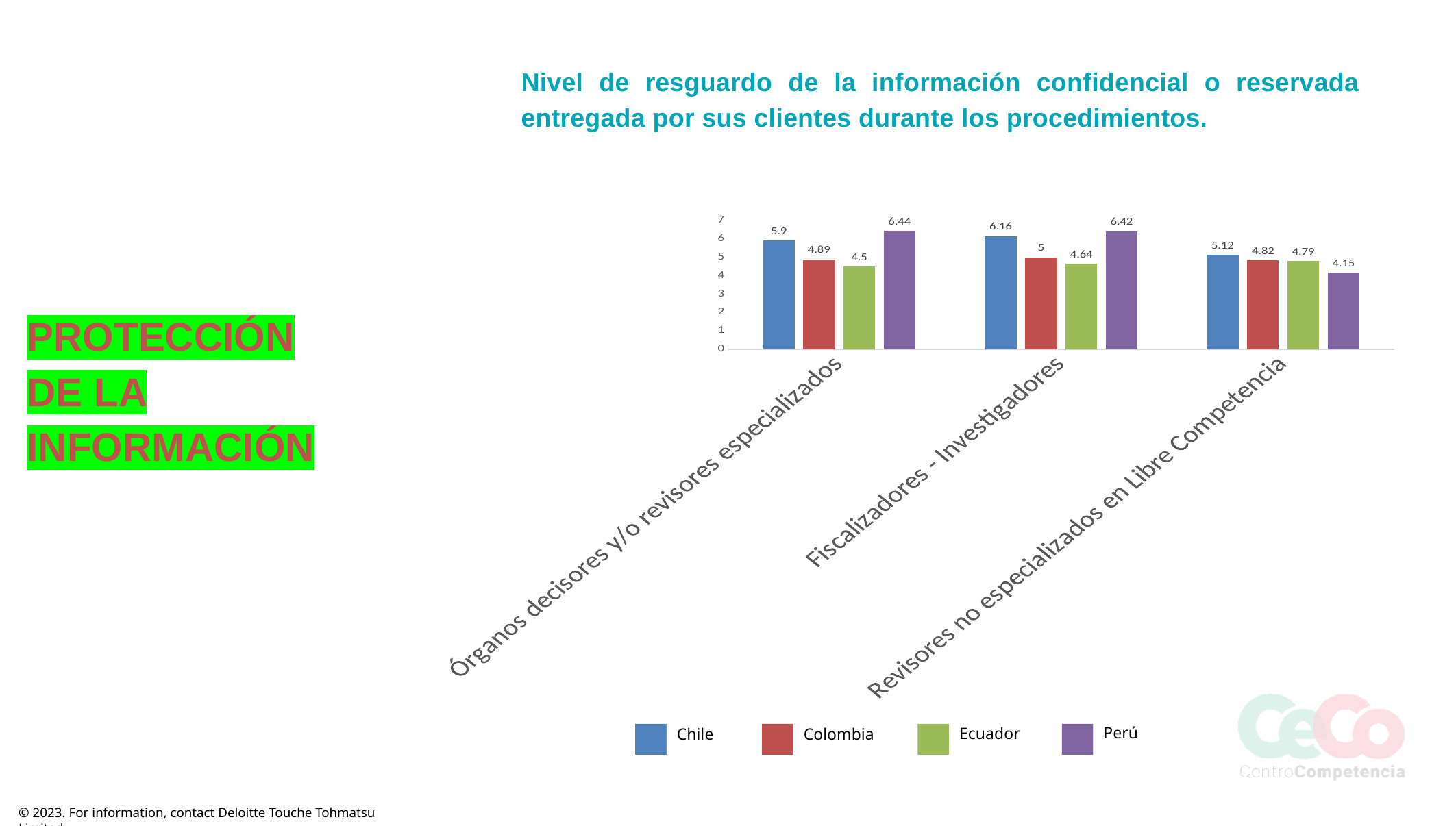
In the 'Órganos decisores y/o revisores especializados' category, which is larger: Chile or Colombia? Chile How many series does the legend list? 4 How many categories are shown on the x axis of the chart? 3 Is the value for Perú in the 'Revisores no especializados en Libre Competencia' category greater or less than 5? less Which country has the highest value in the 'Revisores no especializados en Libre Competencia' category? Chile Which colour represents Perú in the legend? Purple Which country has the lowest value in the 'Órganos decisores y/o revisores especializados' category? Ecuador What kind of chart is shown on the slide? Bar chart What is the value for Perú in the 'Órganos decisores y/o revisores especializados' category? 6.44 What is the value for Colombia in the 'Fiscalizadores - Investigadores' category? 5 What is the difference between Perú and Ecuador in the 'Fiscalizadores - Investigadores' category? 1.78 What is the value for Ecuador in the 'Revisores no especializados en Libre Competencia' category? 4.79